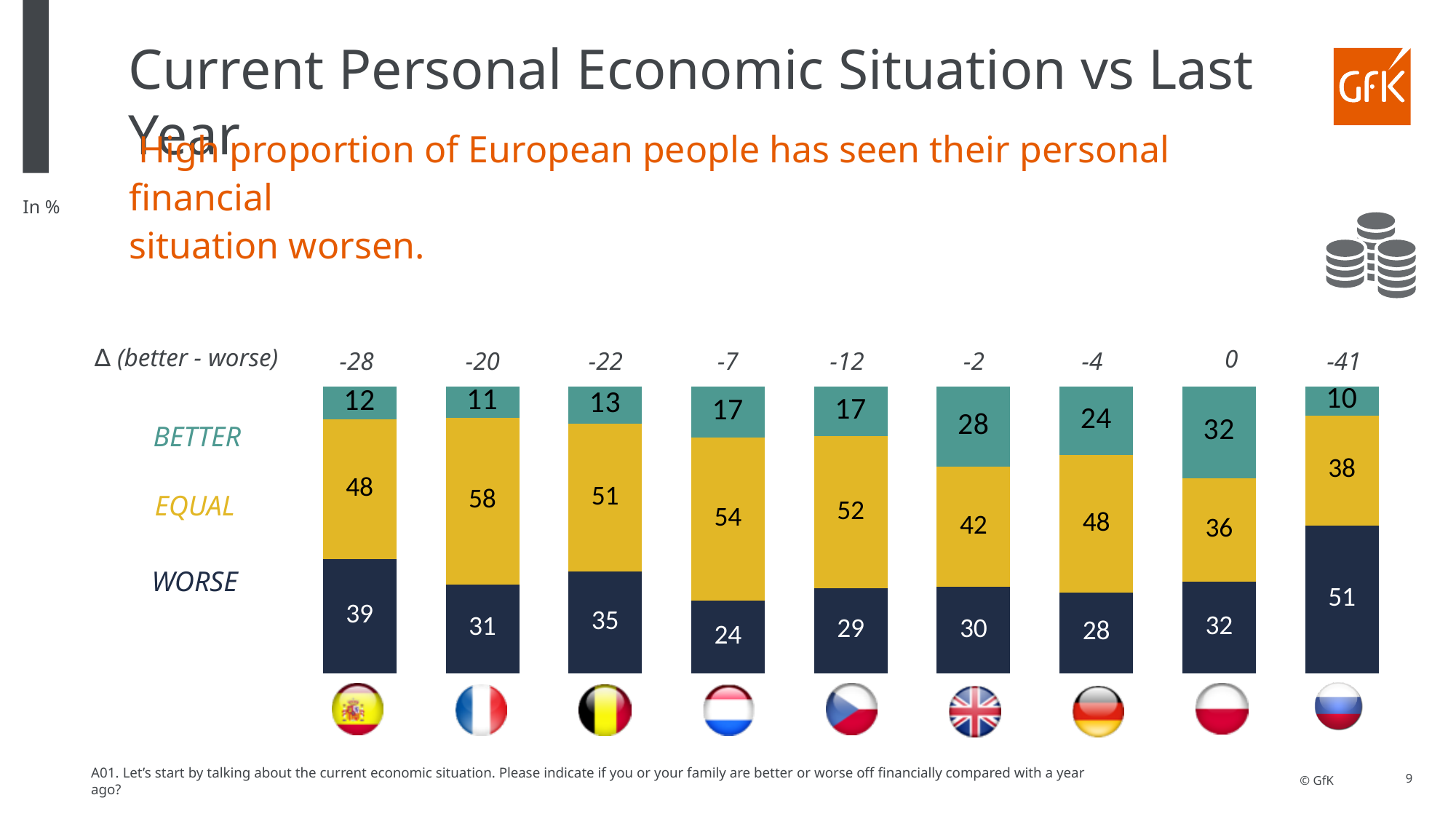
Is the BETTER value larger for the sixth bar (UK flag) or the seventh bar (German flag)? the sixth bar (UK flag), 28 How many series does the chart show (BETTER, EQUAL, WORSE)? 3 Which bar has the highest WORSE value? the last bar on the right (Russian flag), 51 What is the WORSE value for the first bar from the left (Spanish flag)? 39 What is the total of the stacked bar for the first bar from the left (Spanish flag)? 99 What kind of chart is shown on the slide? stacked bar chart What is the Δ (better - worse) value shown above the eighth bar (Polish flag)? 0 What is the EQUAL value for the second bar from the left (French flag)? 58 What is the difference between the WORSE value of the last bar (Russian flag, 51) and the WORSE value of the fourth bar (Dutch flag, 24)? 27 Which bar has the lowest BETTER value? the last bar on the right (Russian flag), 10 How many country bars are shown in the chart? 9 What is the BETTER value for the last bar on the right (Russian flag)? 10